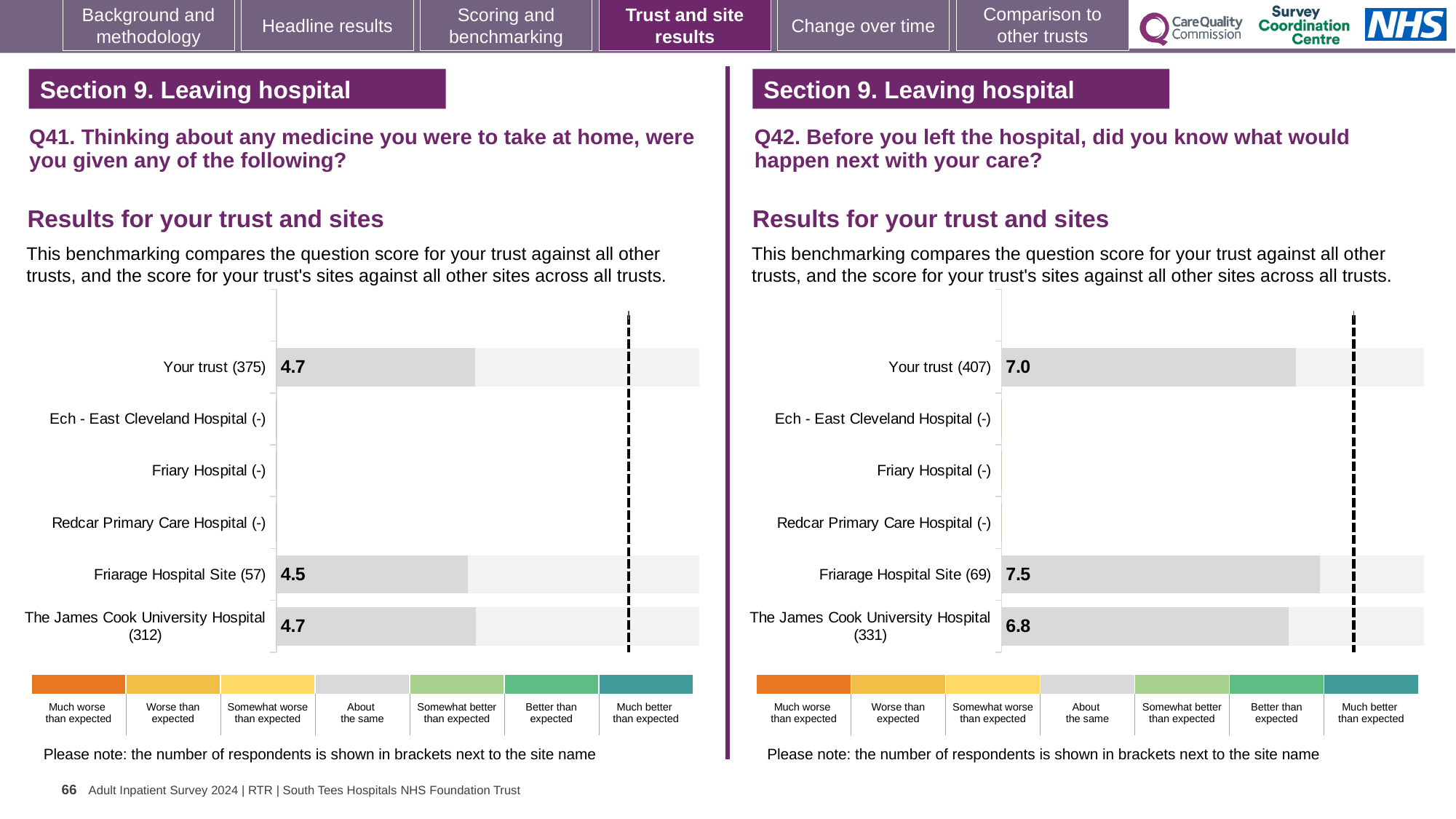
On the Q42 chart (right), which labelled bar has the lowest score? The James Cook University Hospital On the Q41 chart (left), what is the difference between the scores for Your trust and Friarage Hospital Site? 0.2 On the Q42 chart (right), which is larger: the score for Friarage Hospital Site or for Your trust? Friarage Hospital Site On the Q42 chart (right), what is the score for Your trust? 7.0 What kind of chart is used on the Q42 chart (right)? Bar chart On the Q42 chart (right), what is the score for The James Cook University Hospital? 6.8 On the Q42 chart (right), which site has the highest score? Friarage Hospital Site How many site or trust categories are listed on the Q41 chart (left)? 6 On the Q42 chart (right), what is the difference between the scores for Friarage Hospital Site and The James Cook University Hospital? 0.7 On the Q41 chart (left), which is larger: the score for Your trust or for Friarage Hospital Site? Your trust On the Q41 chart (left), what is the score for Friarage Hospital Site? 4.5 On the Q41 chart (left), what is the score for Your trust? 4.7